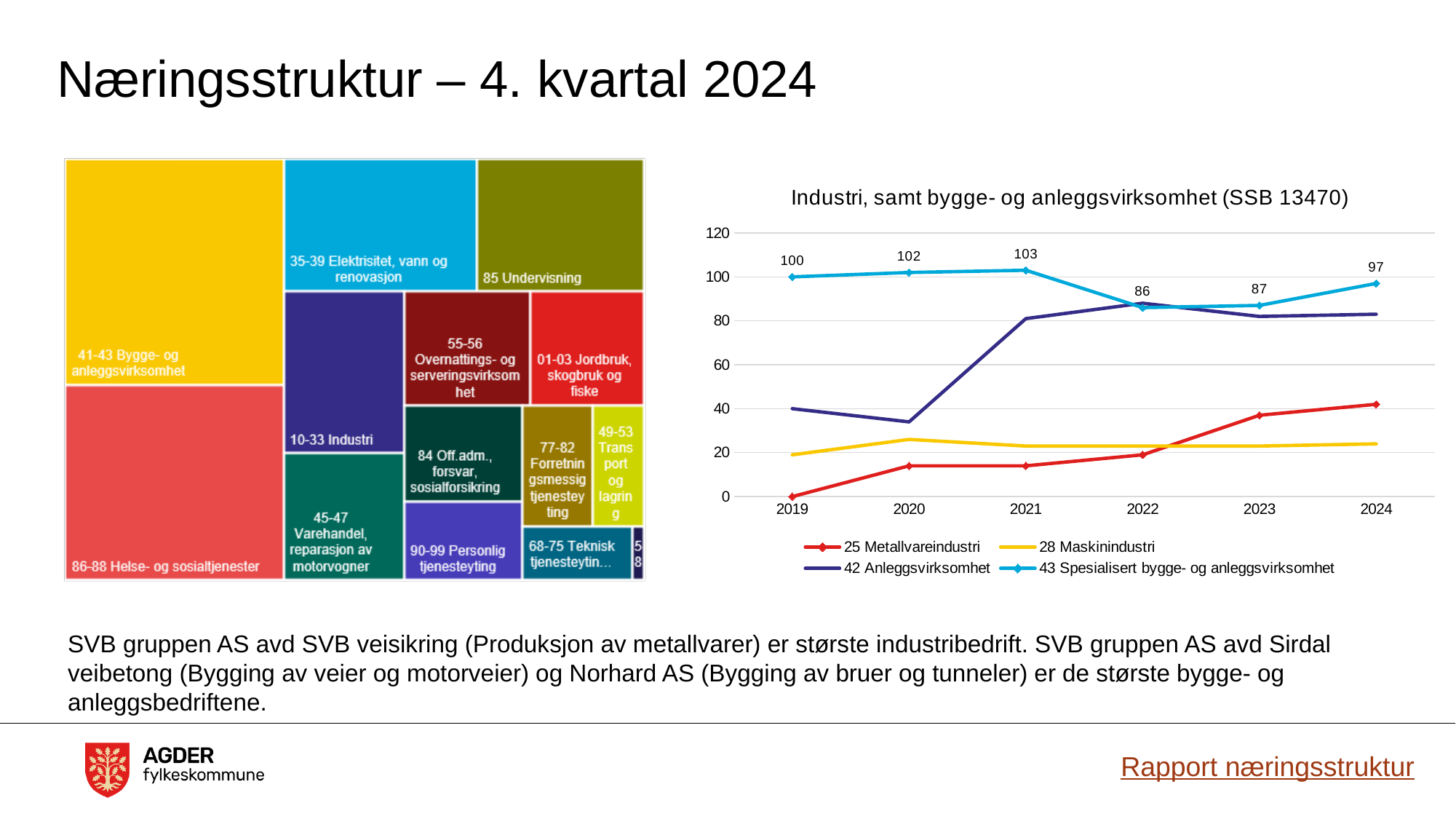
In the chart 'Industri, samt bygge- og anleggsvirksomhet (SSB 13470)', is the value for 25 Metallvareindustri in 2024 greater or less than 20? greater What type of chart is the chart titled 'Industri, samt bygge- og anleggsvirksomhet (SSB 13470)'? line chart In the chart 'Industri, samt bygge- og anleggsvirksomhet (SSB 13470)', in which year does 43 Spesialisert bygge- og anleggsvirksomhet reach its highest value? 2021 In the chart 'Industri, samt bygge- og anleggsvirksomhet (SSB 13470)', is the value for 42 Anleggsvirksomhet in 2019 greater or less than 60? less In the chart 'Industri, samt bygge- og anleggsvirksomhet (SSB 13470)', what is the difference between the 2021 and 2022 values for 43 Spesialisert bygge- og anleggsvirksomhet? 17 In the chart 'Industri, samt bygge- og anleggsvirksomhet (SSB 13470)', is the value for 43 Spesialisert bygge- og anleggsvirksomhet higher in 2020 or in 2023? 2020 In the chart 'Industri, samt bygge- og anleggsvirksomhet (SSB 13470)', in which year does 43 Spesialisert bygge- og anleggsvirksomhet have its lowest value? 2022 In the chart 'Industri, samt bygge- og anleggsvirksomhet (SSB 13470)', what is the value for 43 Spesialisert bygge- og anleggsvirksomhet in 2024? 97 In the chart 'Industri, samt bygge- og anleggsvirksomhet (SSB 13470)', what is the value for 43 Spesialisert bygge- og anleggsvirksomhet in 2019? 100 In the chart 'Industri, samt bygge- og anleggsvirksomhet (SSB 13470)', what is the value for 43 Spesialisert bygge- og anleggsvirksomhet in 2022? 86 How many series does the legend of the chart 'Industri, samt bygge- og anleggsvirksomhet (SSB 13470)' list? 4 In the chart 'Industri, samt bygge- og anleggsvirksomhet (SSB 13470)', does the 25 Metallvareindustri series generally rise or fall from 2019 to 2024? rise